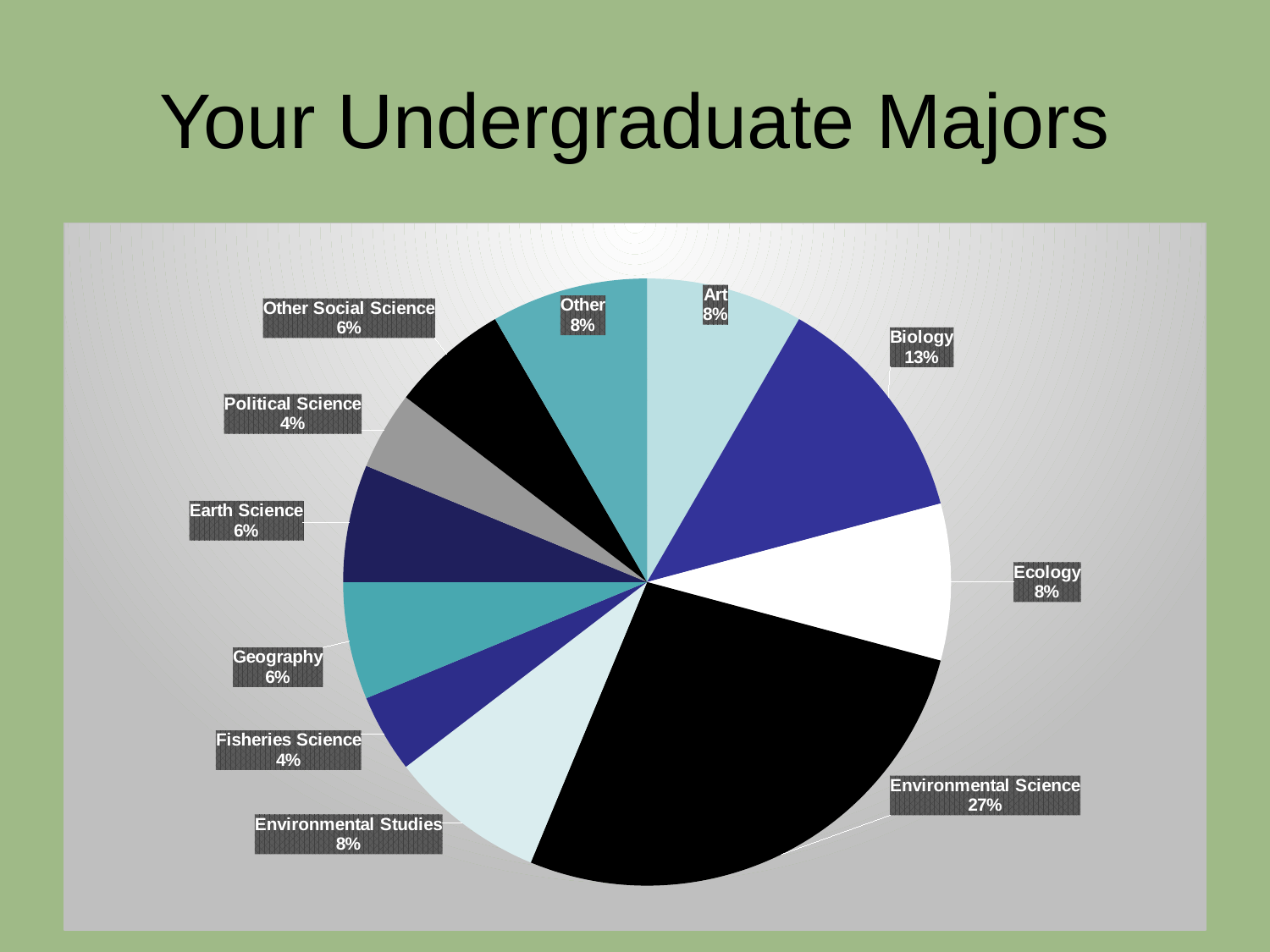
What percentage is shown for Fisheries Science? 4% What type of chart is shown on the slide? pie chart Which is larger, the share for Other Social Science or the share for Fisheries Science? Other Social Science What percentage of undergraduate majors is Environmental Science? 27% What percentage of undergraduate majors is Biology? 13% What percentage is shown for Geography? 6% What is the difference in percentage points between Earth Science and Political Science? 2 What is the difference in percentage points between Environmental Science and Biology? 14 Which major has the largest share of the pie? Environmental Science How many slices does the pie chart have? 11 What is the title of the slide? Your Undergraduate Majors Which is larger, the share for Biology or the share for Ecology? Biology